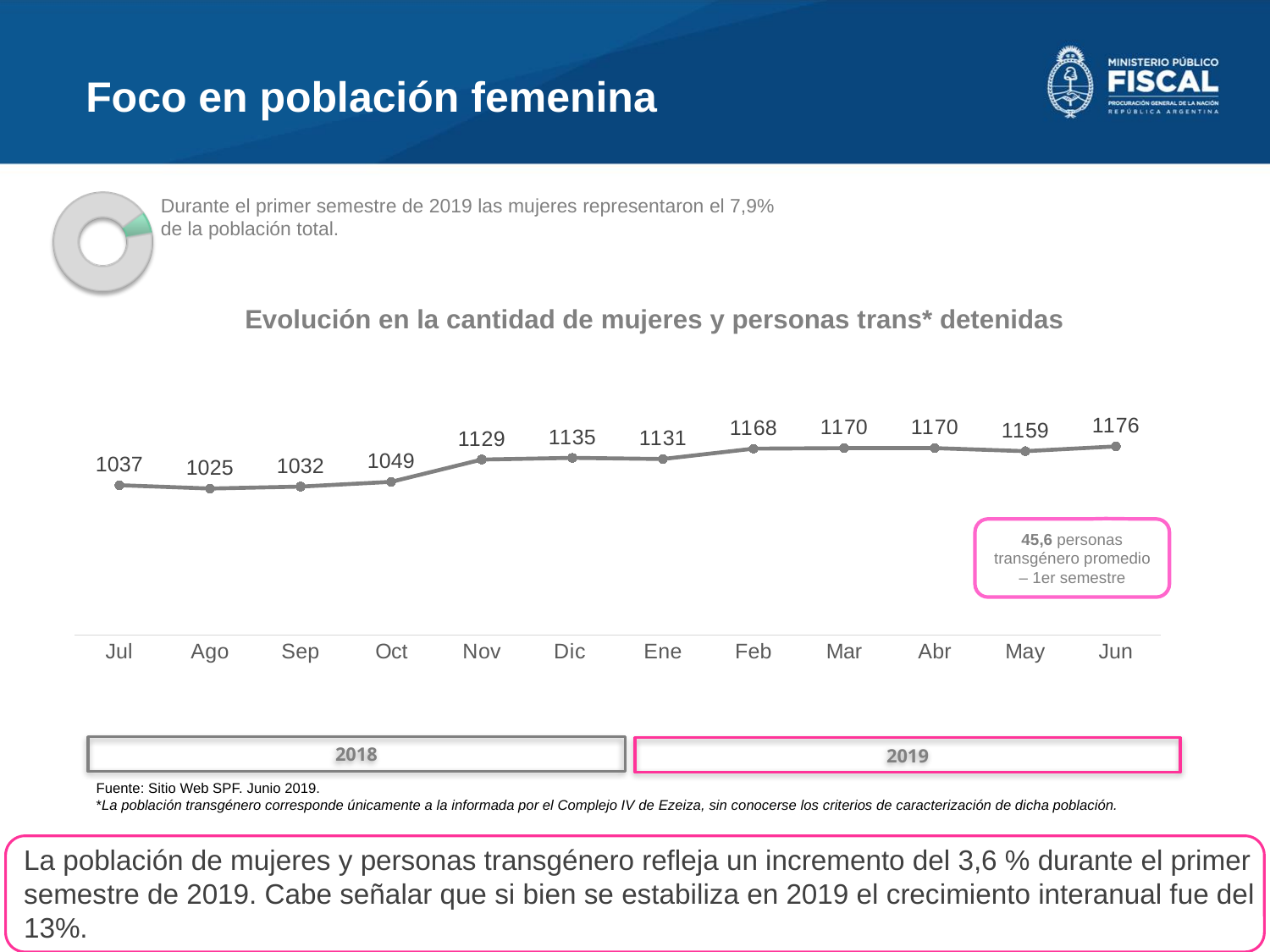
What is the value for Jul in the line chart? 1037 Which month has the highest value in the line chart? Jun What is the value for Feb in the line chart? 1168 What is the difference between the values for Nov and Oct in the line chart? 80 What is the value for Nov in the line chart? 1129 How many months are plotted in the line chart? 12 What is the title of the line chart? Evolución en la cantidad de mujeres y personas trans* detenidas Do the values in the line chart generally rise or fall from Jul to Jun? Rise Which month has the lowest value in the line chart? Ago What kind of chart shows the evolution of detained women and trans persons? Line chart What is the difference between the values for Jun and Jul in the line chart? 139 Which is larger in the line chart, the value for Dic or the value for Ene? Dic